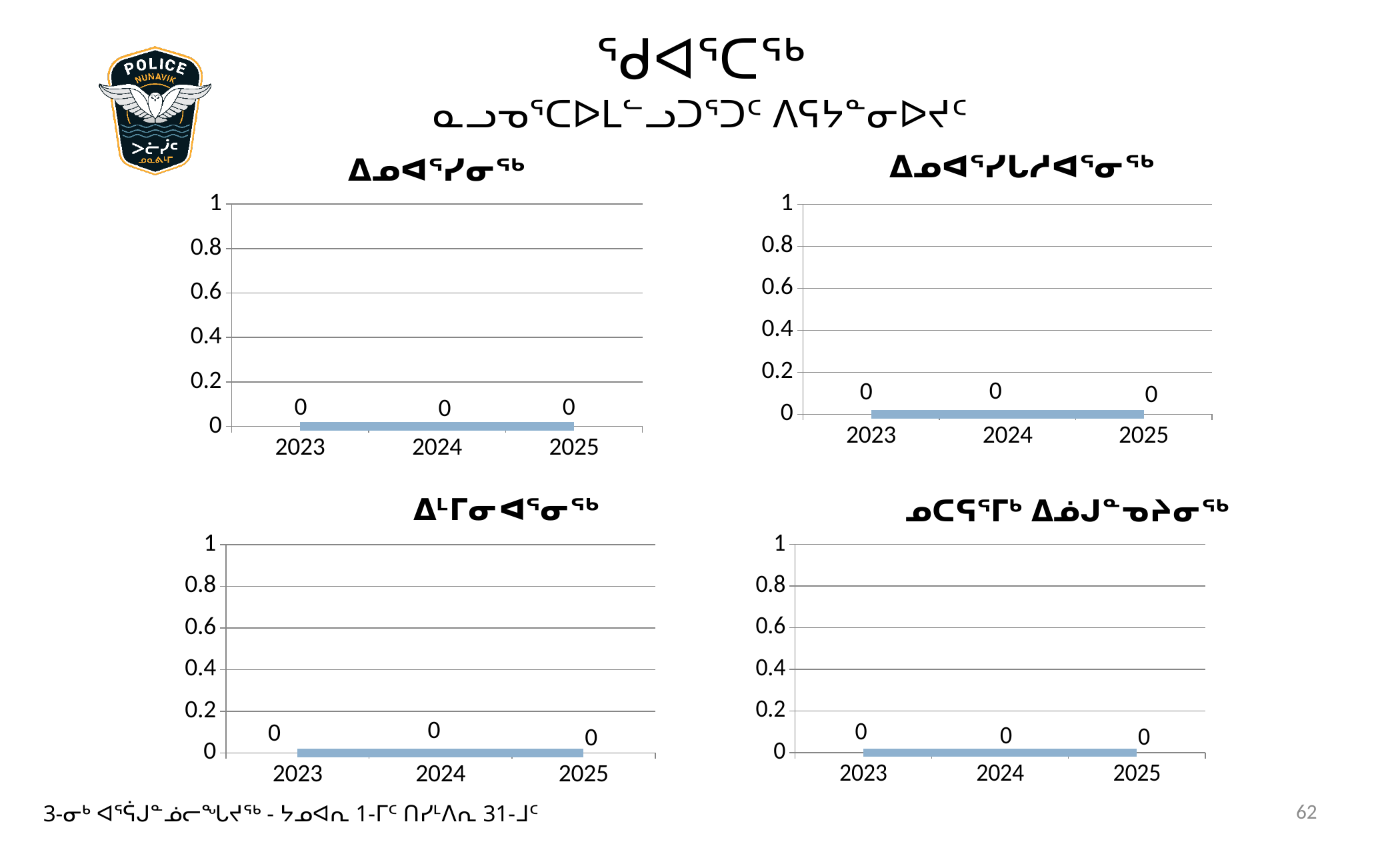
What is the highest value shown on the y axis of the top-left chart? 1 How many categories are shown on the x axis of the top-left chart? 3 In the top-right chart, what is the difference between the values for 2023 and 2025? 0 In the bottom-right chart, is the value for 2024 greater or less than 0.2? less In the top-left chart, what is the value for 2023? 0 How many years are plotted in the bottom-right chart? 3 In the top-right chart, what is the value for 2024? 0 How many charts are shown on the slide? 4 In the bottom-right chart, what is the value for 2023? 0 What kind of chart is the top-right chart? line chart In the bottom-left chart, what is the value for 2025? 0 In the bottom-left chart, do the values rise, fall, or stay the same from 2023 to 2025? stay the same